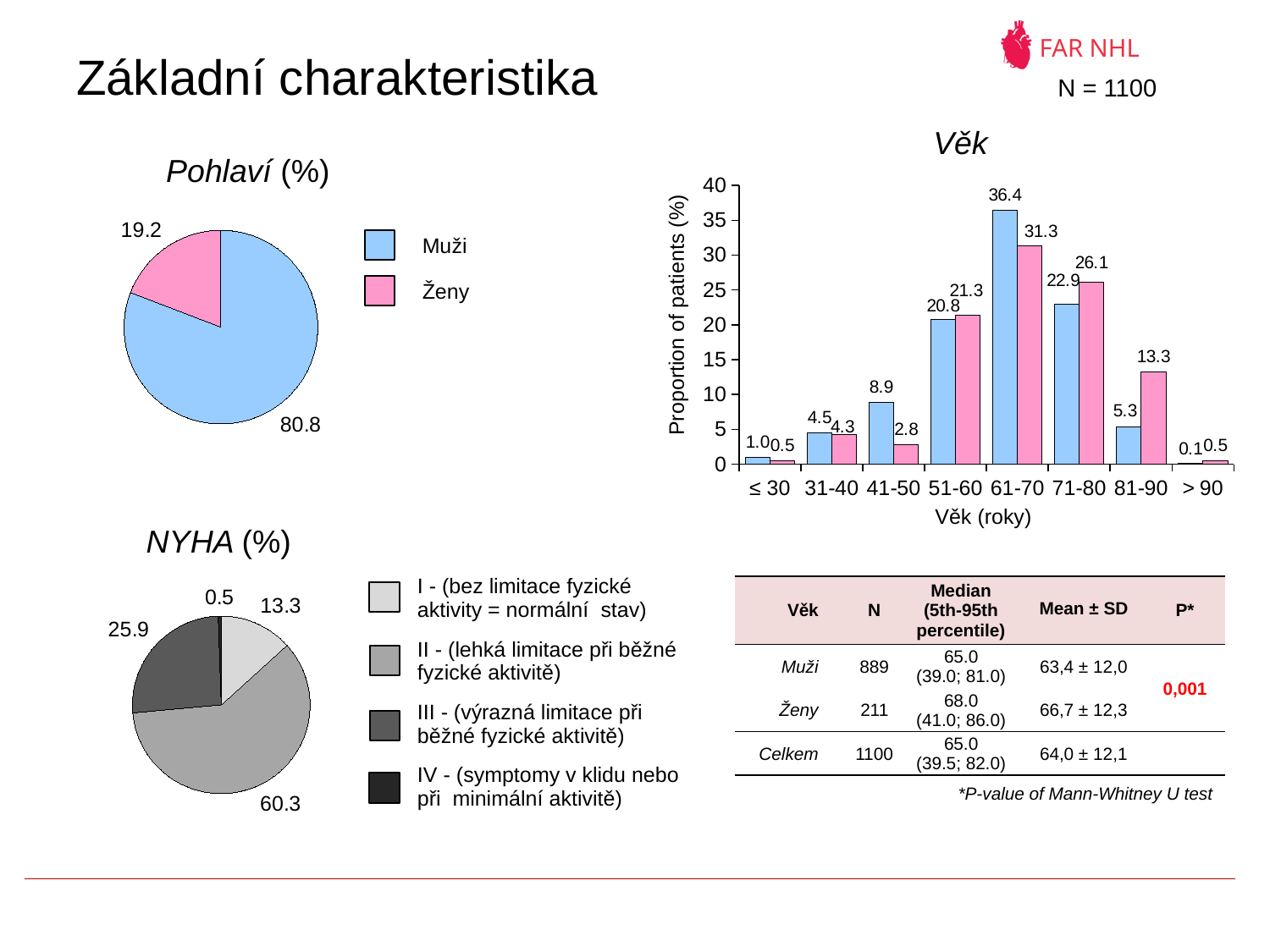
In the NYHA (%) pie chart, what is the value for class II? 60.3 In the Věk bar chart, what is the value of the pink (Ženy) bar for the 81-90 age group? 13.3 In the Věk bar chart, which age group has the highest blue (Muži) bar? 61-70 In the Věk bar chart, for the 71-80 age group, which bar is larger, the blue (Muži) or the pink (Ženy)? pink (Ženy) In the Věk bar chart, what is the value of the blue (Muži) bar for the 61-70 age group? 36.4 What type of chart is the Věk chart? bar chart In the Pohlaví (%) pie chart, what share is labelled for Ženy? 19.2 In the Pohlaví (%) pie chart, which category has the larger slice? Muži In the Věk bar chart, which age group has the lowest blue (Muži) bar? > 90 In the Věk bar chart, what is the difference between the blue (Muži) and pink (Ženy) bars for the 41-50 age group? 6.1 In the NYHA (%) pie chart, which class has the smallest slice? IV How many age groups are shown on the x axis of the Věk bar chart? 8